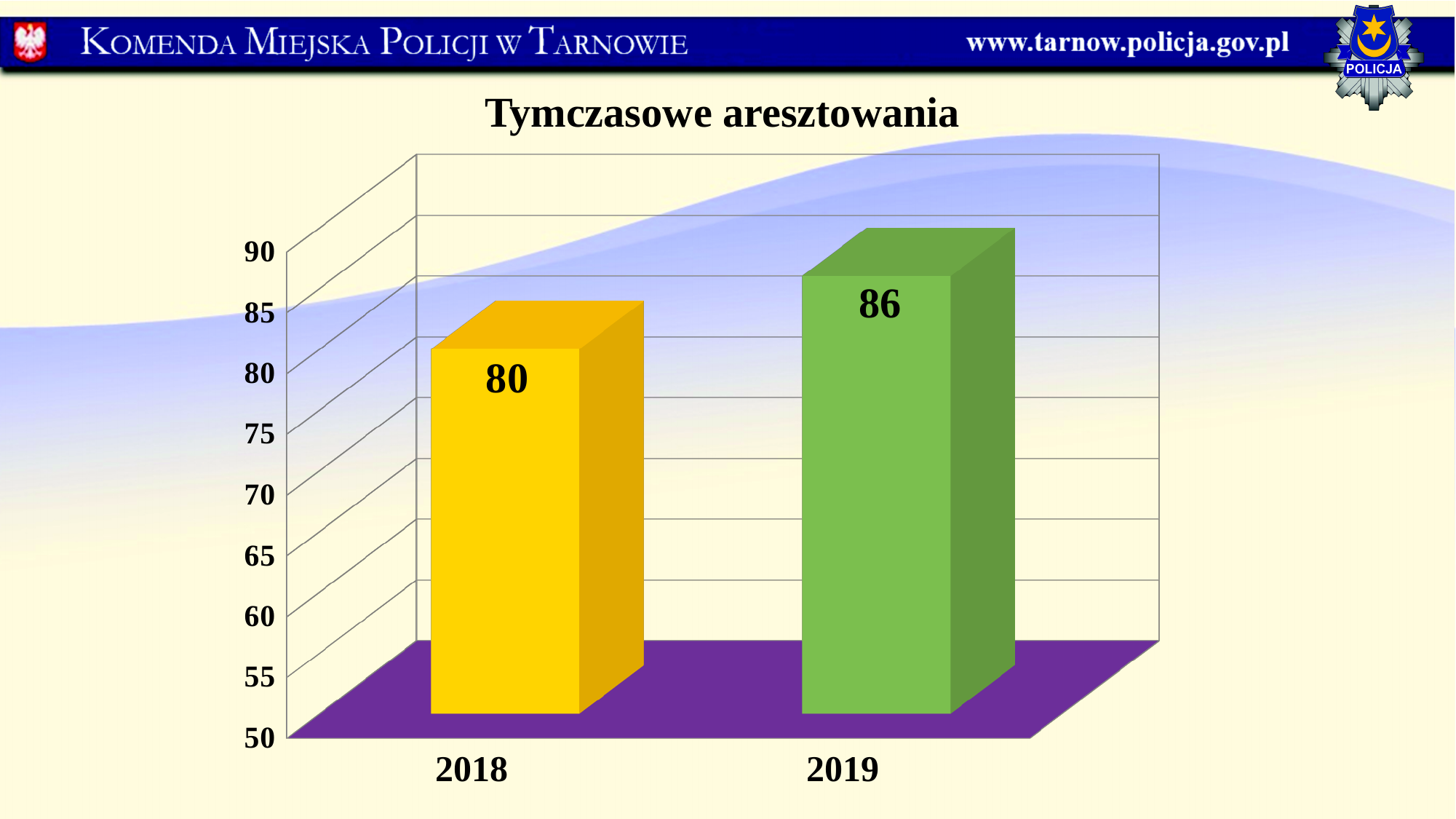
Is the value for 2019 greater or less than 90? less What is the value for 2019? 86 What is the difference between the values for 2019 and 2018? 6 What is the value for 2018? 80 Which year has the highest value? 2019 Which year has the lowest value? 2018 Do the values rise or fall from 2018 to 2019? rise How many years are shown on the chart? 2 Which is larger, the value for 2018 or the value for 2019? 2019 Is the value for 2018 greater or less than 75? greater What is the title of the chart? Tymczasowe aresztowania What kind of chart is shown on the slide? bar chart